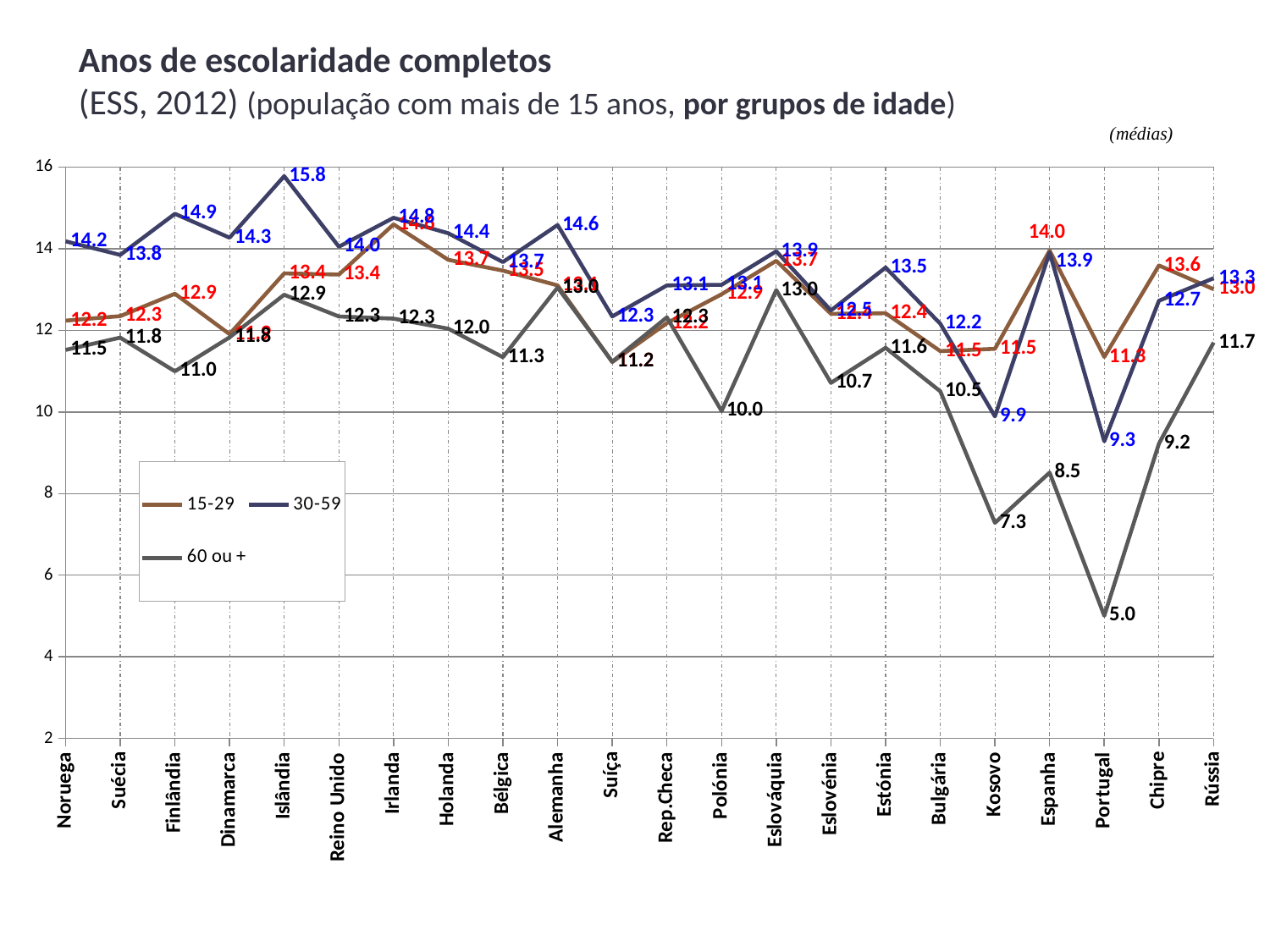
What kind of chart is shown on the slide? Line chart In Kosovo, which series has the larger value: 15-29 or 30-59? 15-29 How many countries are plotted along the x axis? 22 What is the value for the 60 ou + series in Portugal? 5.0 Is the value for the 60 ou + series in Espanha greater or less than 10? less Which country has the highest value for the 30-59 series? Islândia What is the value for the 30-59 series in Islândia? 15.8 Which country has the lowest value for the 60 ou + series? Portugal Which series is drawn in grey in the legend? 60 ou + How many series does the legend list? 3 What is the value for the 60 ou + series in Kosovo? 7.3 What is the difference between the 30-59 value (9.3) and the 60 ou + value (5.0) in Portugal? 4.3